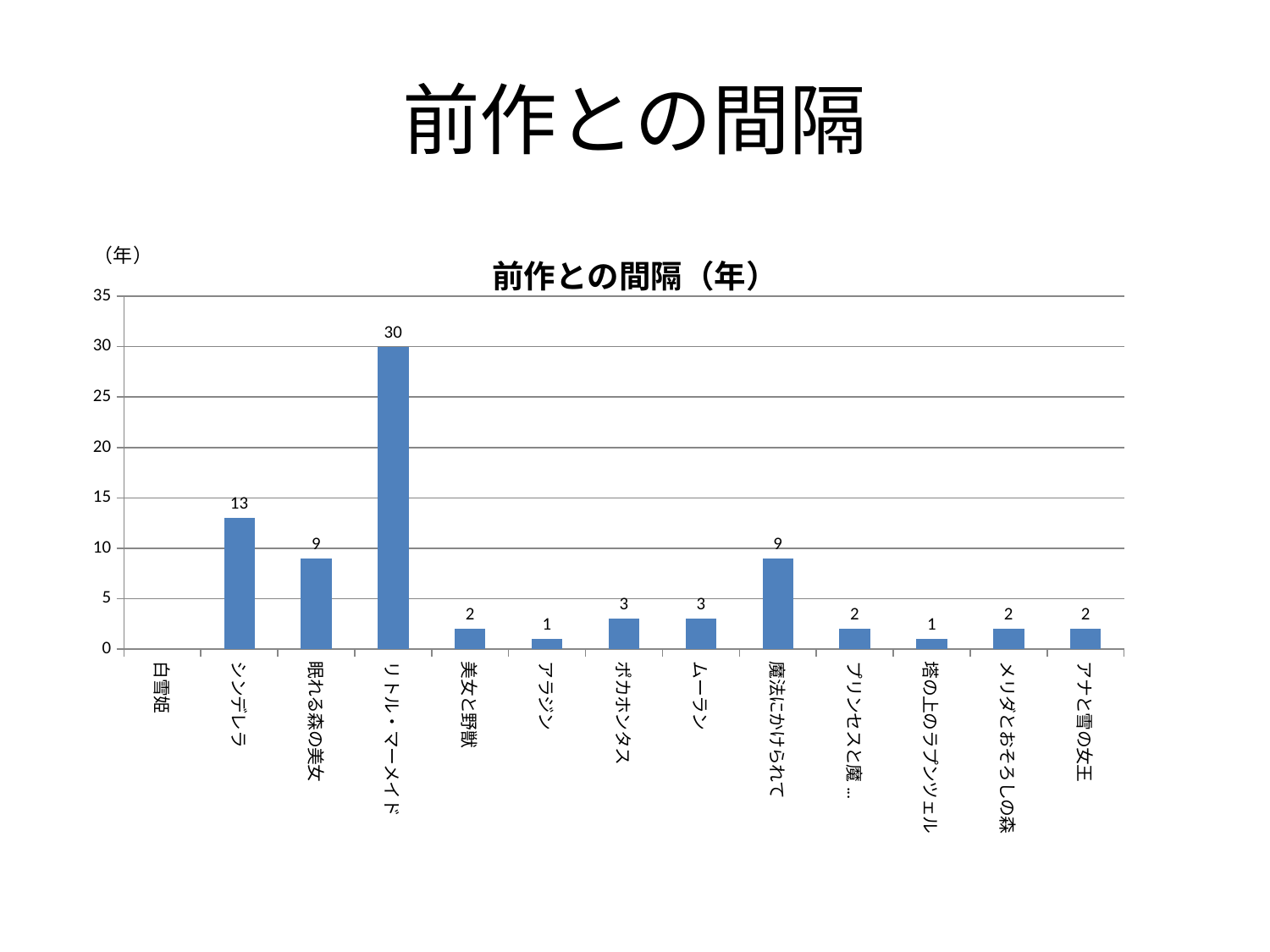
What is the value for アナと雪の女王? 2 What is the title of the chart? 前作との間隔（年） What kind of chart is this? bar chart Which category has the highest value? リトル・マーメイド How many categories are shown on the x axis? 13 Which is larger, the value for シンデレラ or the value for 魔法にかけられて? シンデレラ What is the difference between the values for リトル・マーメイド and シンデレラ? 17 Is the value for リトル・マーメイド greater or less than 25? greater What is the value for シンデレラ? 13 What is the difference between the values for 眠れる森の美女 and 美女と野獣? 7 What is the value for リトル・マーメイド? 30 What is the value for 魔法にかけられて? 9